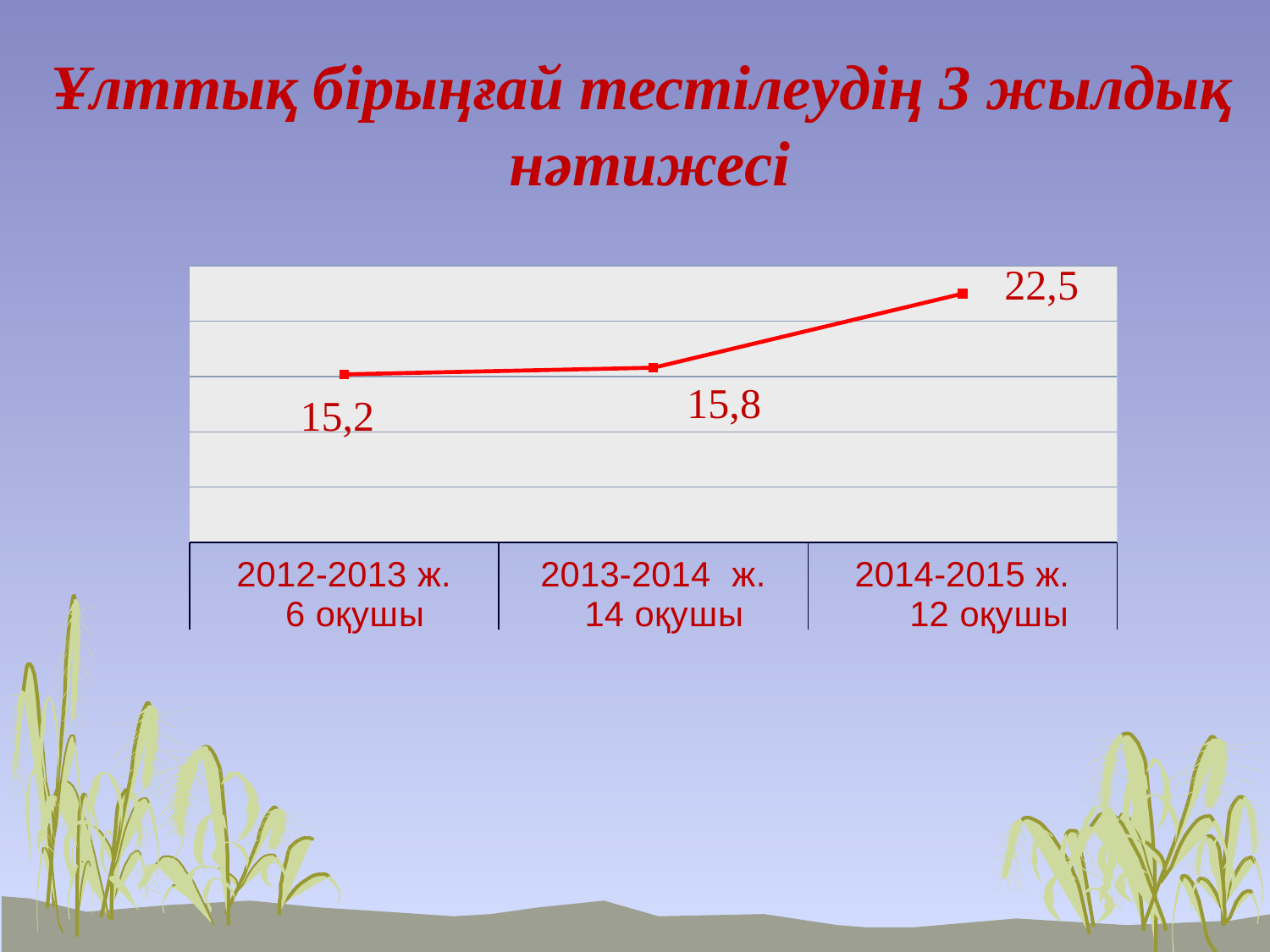
Which year has the lowest value? 2012-2013 ж. What is the difference between the values for 2014-2015 ж. and 2012-2013 ж.? 7,3 Which year has the highest value? 2014-2015 ж. What kind of chart is shown on the slide? line chart Do the values rise or fall from 2012-2013 ж. to 2014-2015 ж.? rise What is the value for 2012-2013 ж.? 15,2 What is the difference between the values for 2014-2015 ж. and 2013-2014 ж.? 6,7 How many students (оқушы) are listed under the 2013-2014 ж. category label? 14 оқушы What is the value for 2013-2014 ж.? 15,8 How many data points are plotted on the chart? 3 What is the value for 2014-2015 ж.? 22,5 Which is larger, the value for 2014-2015 ж. or the value for 2012-2013 ж.? 2014-2015 ж.